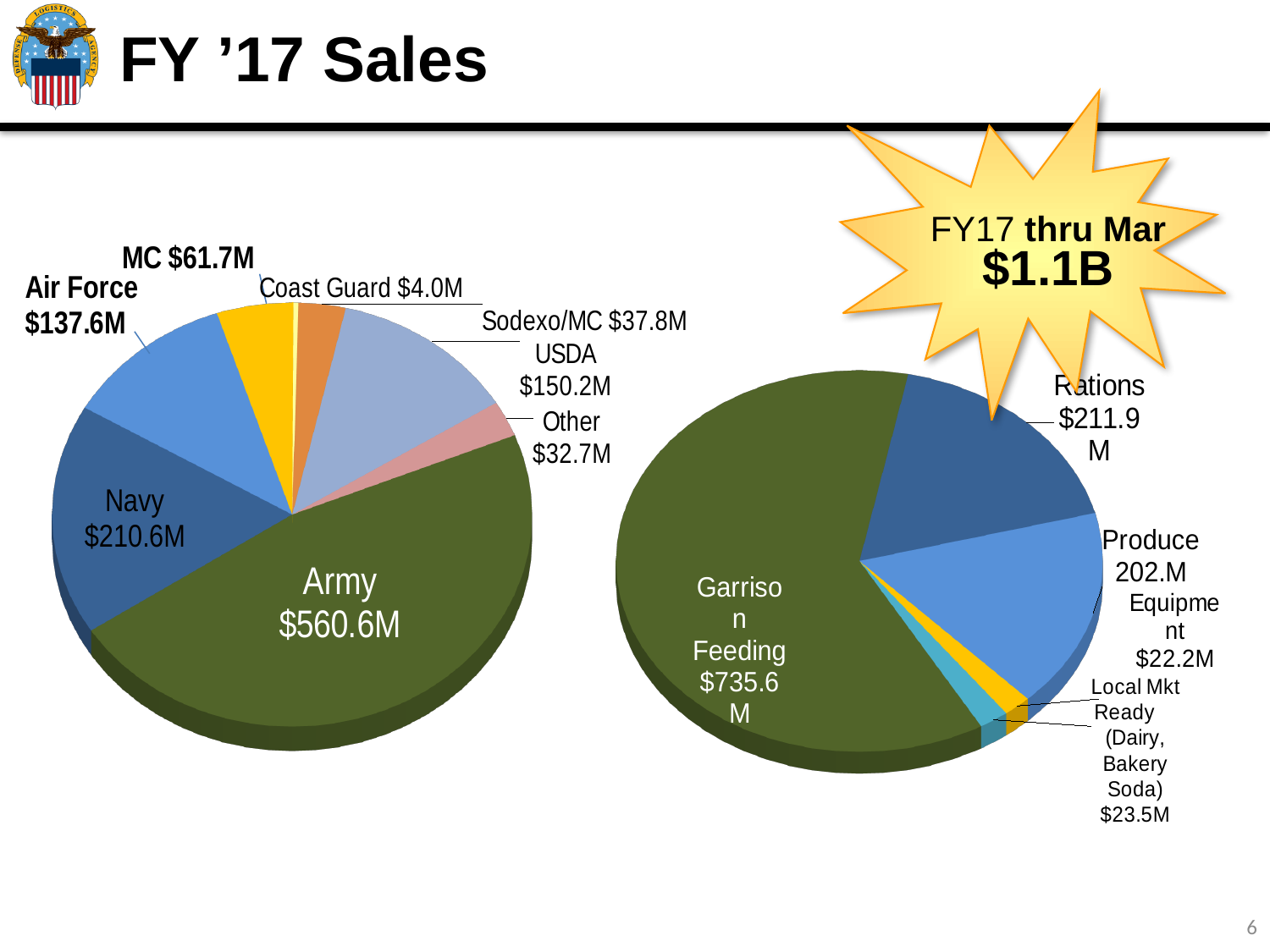
In the left pie chart, what is the value for Army? $560.6M In the left pie chart, which category has the largest slice? Army In the left pie chart, which is larger, Navy or Air Force? Navy In the left pie chart, what is the difference between the Army and Navy values? $350.0M In the right pie chart, which category has the smallest value? Equipment How many slices does the left pie chart have? 8 What type of chart is shown on the right side of the slide? Pie chart In the right pie chart, what is the value for Rations? $211.9M How many slices does the right pie chart have? 5 In the left pie chart, what is the value for USDA? $150.2M In the right pie chart, what is the value for Garrison Feeding? $735.6M In the left pie chart, which category has the smallest slice? Coast Guard